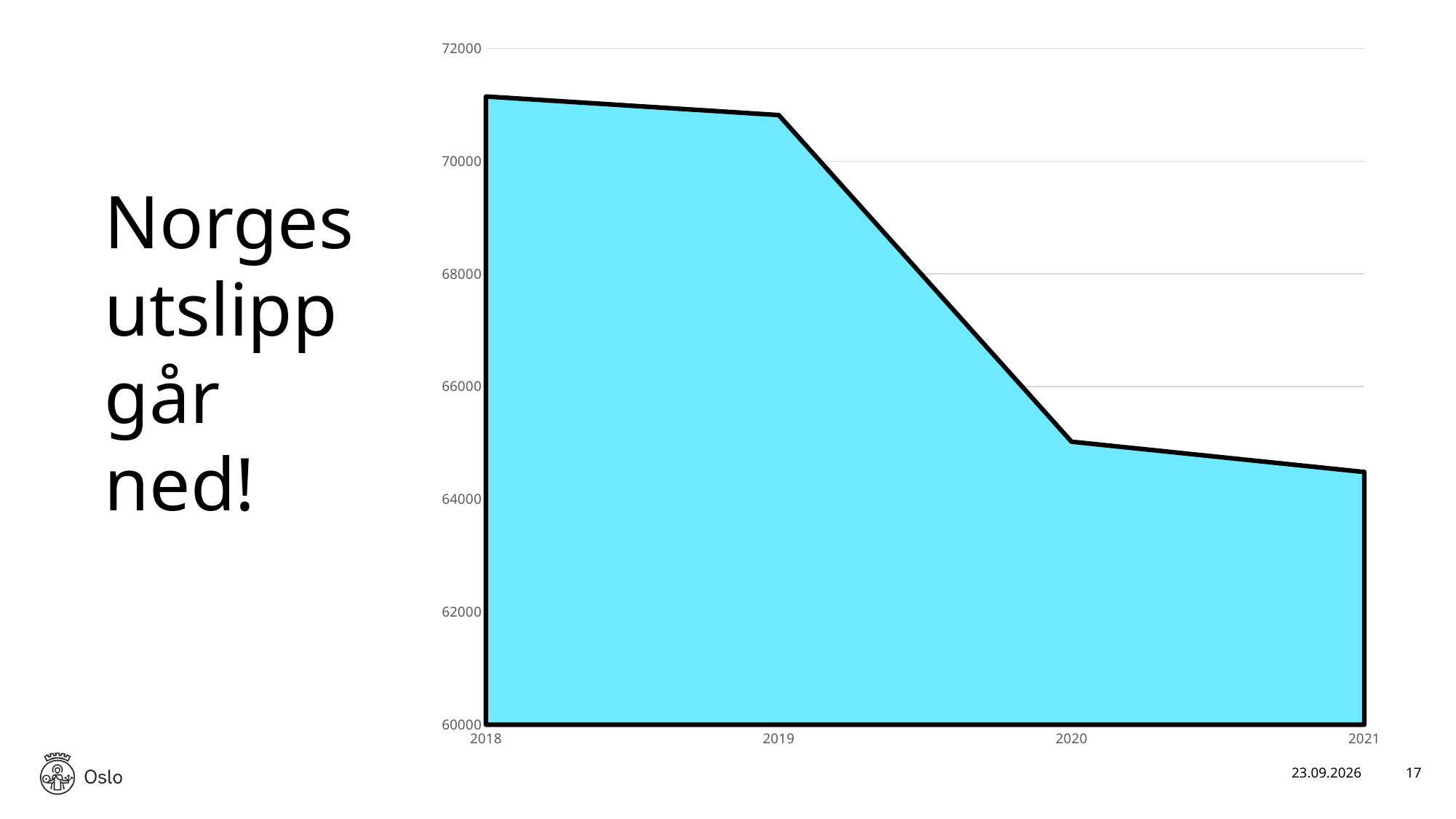
Is the value for 2018 greater or less than 70000? greater Which year has the highest value in the chart? 2018 How many years are plotted along the x axis of the chart? 4 Is the value for 2020 greater or less than 66000? less Is the value for 2021 greater or less than 64000? greater What is the text of the heading next to the chart? Norges utslipp går ned! Which year has the lowest value in the chart? 2021 What is the lowest value shown on the y axis of the chart? 60000 Which is larger, the value for 2019 or the value for 2020? 2019 Do the values in the chart rise or fall from 2018 to 2021? Fall What kind of chart is shown on the slide? Area chart